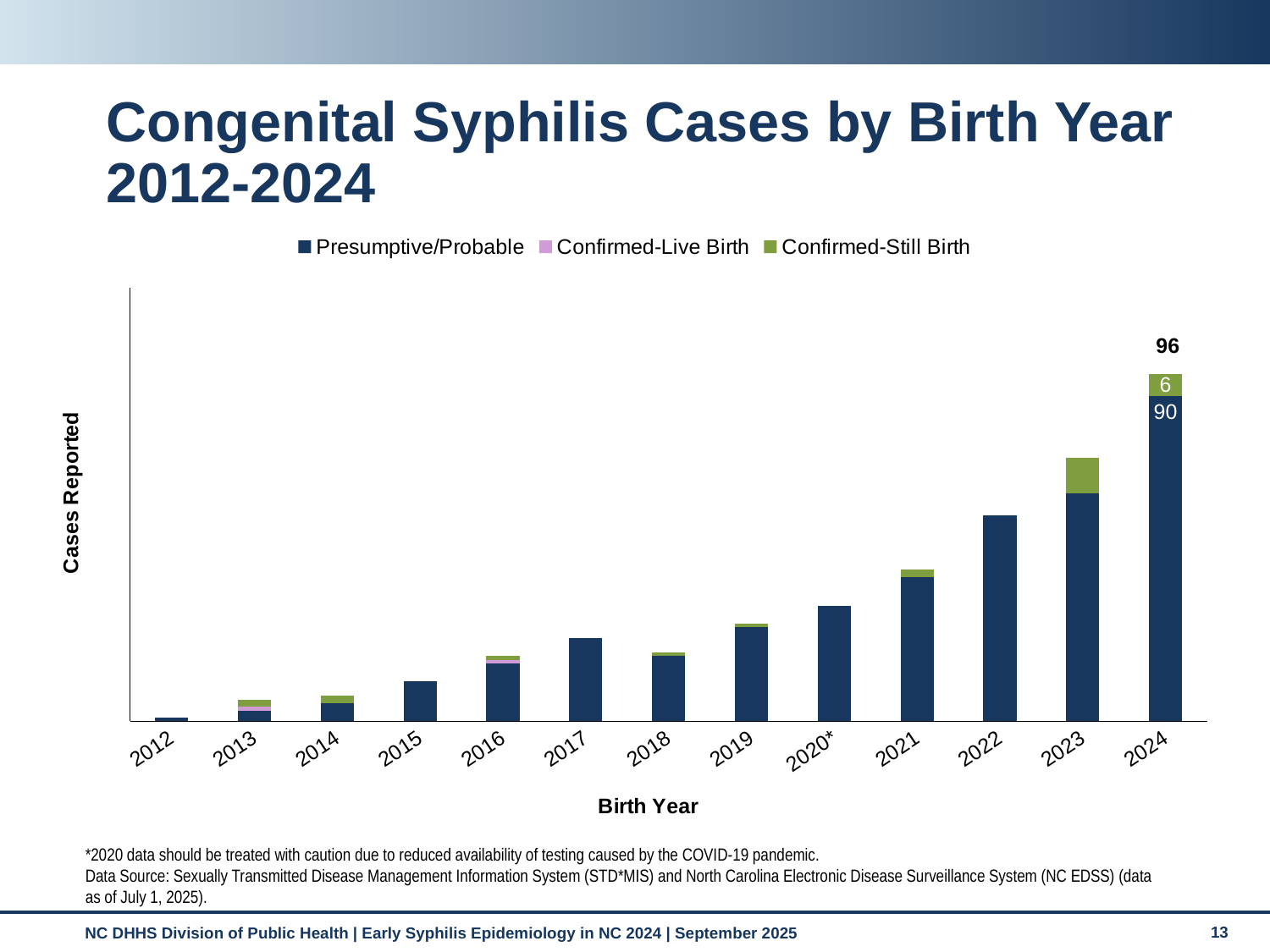
Which birth year has the highest total number of cases reported? 2024 For birth year 2024, what is the difference between the Presumptive/Probable cases and the Confirmed-Still Birth cases? 84 How many Presumptive/Probable cases are shown for birth year 2024? 90 What type of chart is shown on the slide? Stacked bar chart How many series does the legend list? 3 How many birth years are shown on the x axis? 13 Do the total cases reported generally rise or fall from 2012 to 2024? Rise Which birth year on the x axis is marked with an asterisk? 2020 Which birth year has the lowest total number of cases reported? 2012 Which birth year has more cases reported, 2022 or 2023? 2023 What is the total number of congenital syphilis cases reported for birth year 2024? 96 How many Confirmed-Still Birth cases are shown for birth year 2024? 6